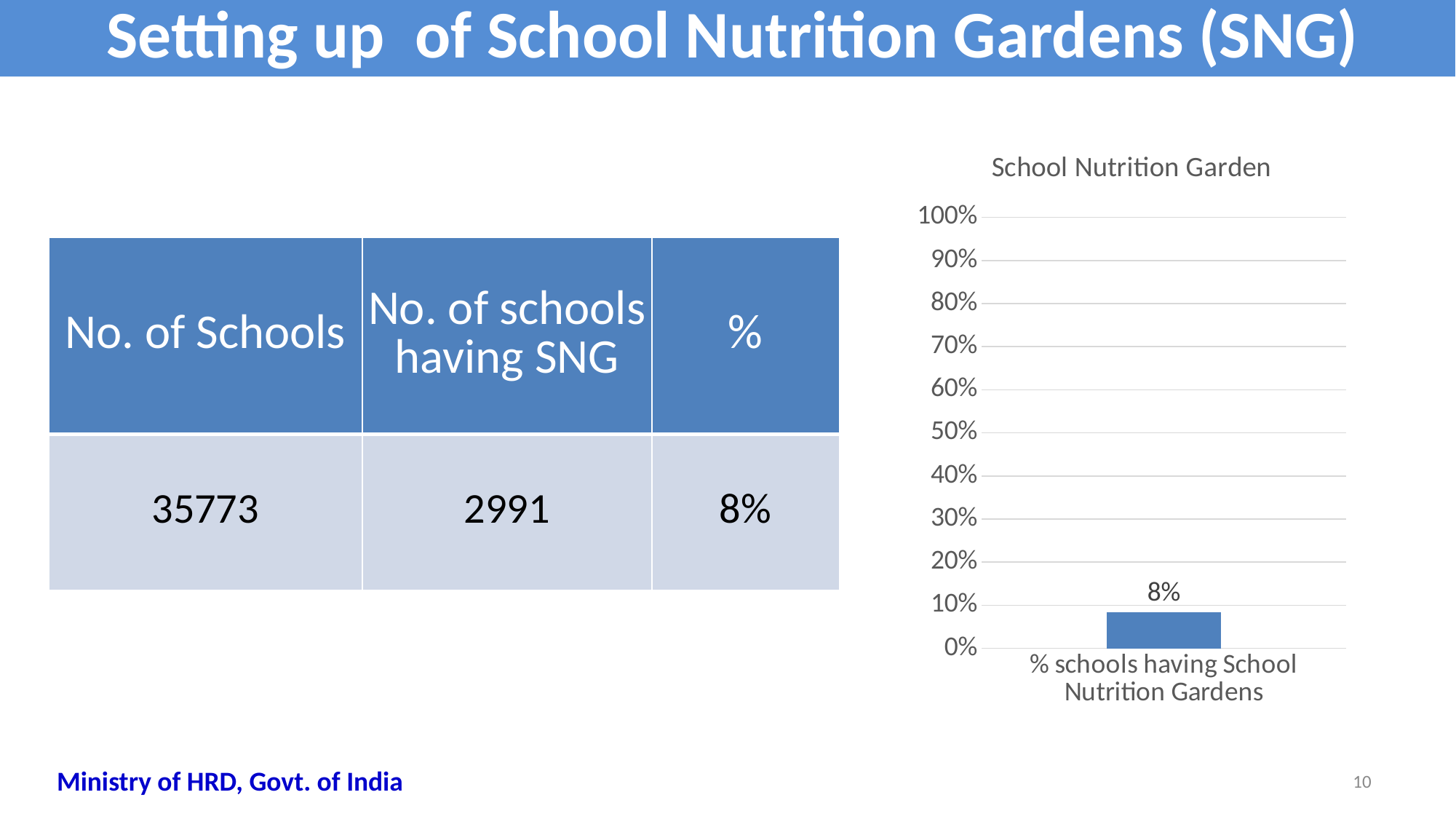
What is the title of the chart? School Nutrition Garden Is the value for '% schools having School Nutrition Gardens' greater or less than 50%? less What is the category label of the single bar in the chart? % schools having School Nutrition Gardens How many bars does the chart show? 1 What kind of chart is shown on the slide? bar chart What is the highest value shown on the chart's vertical axis? 100% Is the value for '% schools having School Nutrition Gardens' greater or less than 10%? less What is the value shown for '% schools having School Nutrition Gardens' in the chart? 8%